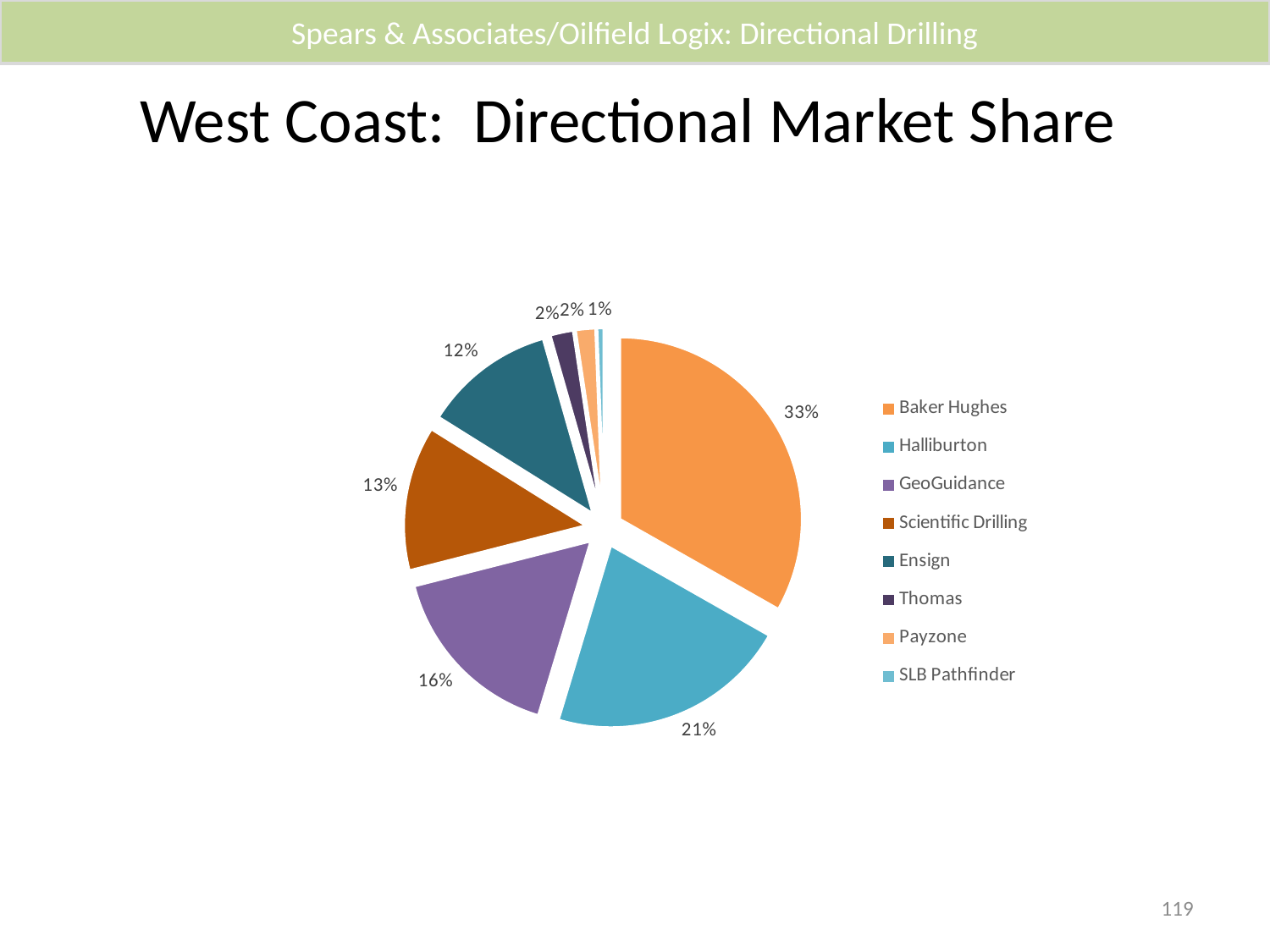
What percentage is shown for GeoGuidance? 16% What percentage of the market does Ensign hold? 12% How many percentage points larger is Baker Hughes' share than Halliburton's? 12 What is Halliburton's share of the pie? 21% Which company has the smallest slice of the pie? SLB Pathfinder What is the title of the slide's chart? West Coast: Directional Market Share What share of the West Coast directional market does Baker Hughes hold? 33% What type of chart is shown on the slide? Pie chart What share does Scientific Drilling have? 13% Which company has the largest slice of the pie? Baker Hughes How many companies are listed in the legend? 8 Which has a larger share, GeoGuidance or Ensign? GeoGuidance